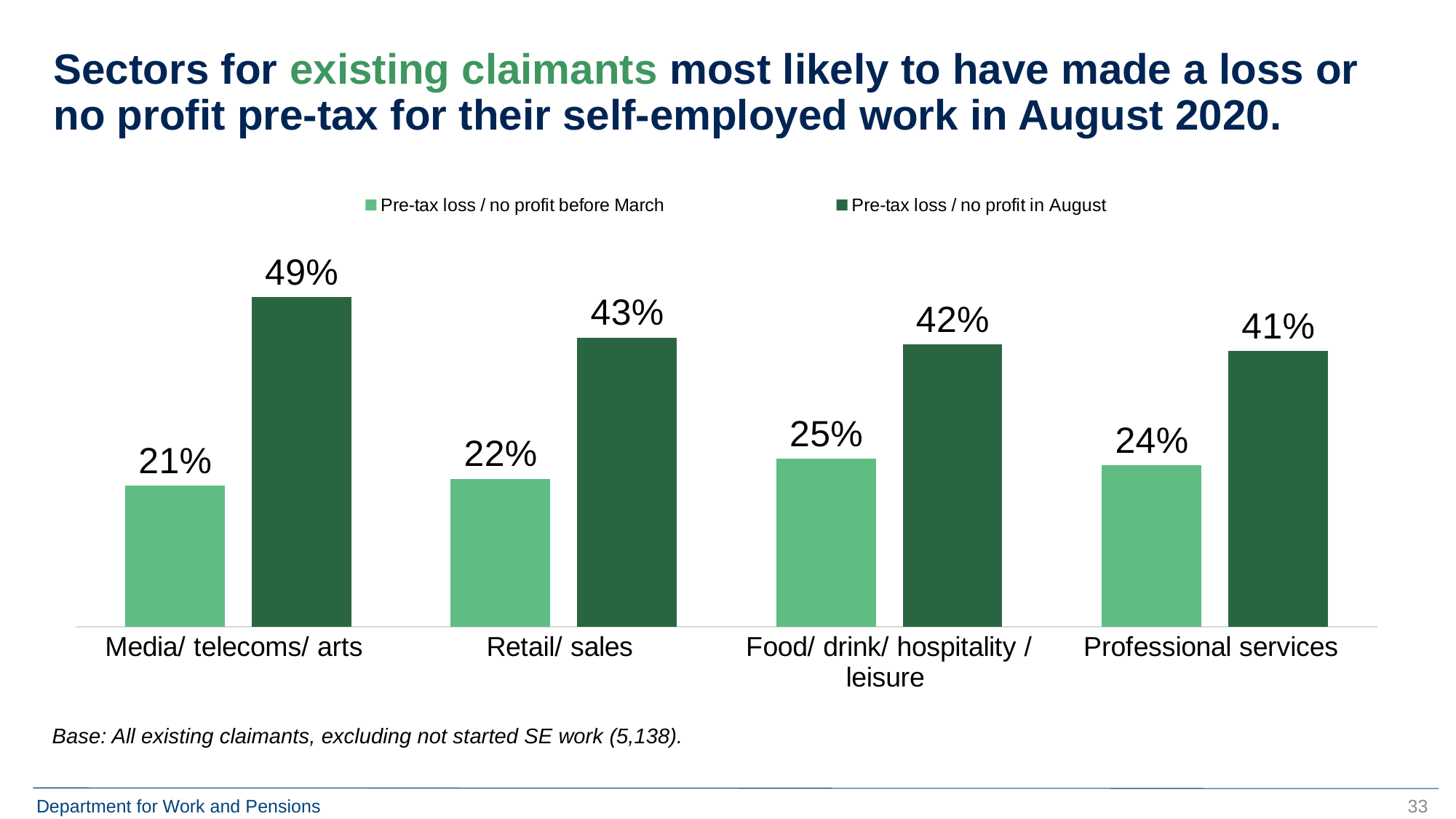
What is the value for 'Pre-tax loss / no profit in August' for Media/ telecoms/ arts? 49% Which is larger for Professional services: the before-March value or the August value? Pre-tax loss / no profit in August What is the value for 'Pre-tax loss / no profit before March' for Professional services? 24% How many sectors are shown on the x axis? 4 Which sector has the highest value for 'Pre-tax loss / no profit in August'? Media/ telecoms/ arts Which sector has the lowest value for 'Pre-tax loss / no profit before March'? Media/ telecoms/ arts What is the base size stated below the chart? 5,138 Which series is shown in the darker green colour? Pre-tax loss / no profit in August What is the value for 'Pre-tax loss / no profit before March' for Food/ drink/ hospitality / leisure? 25% What is the difference between the August and before-March values for Retail/ sales? 21 percentage points How many series does the legend list? 2 What kind of chart is shown on the slide? Bar chart